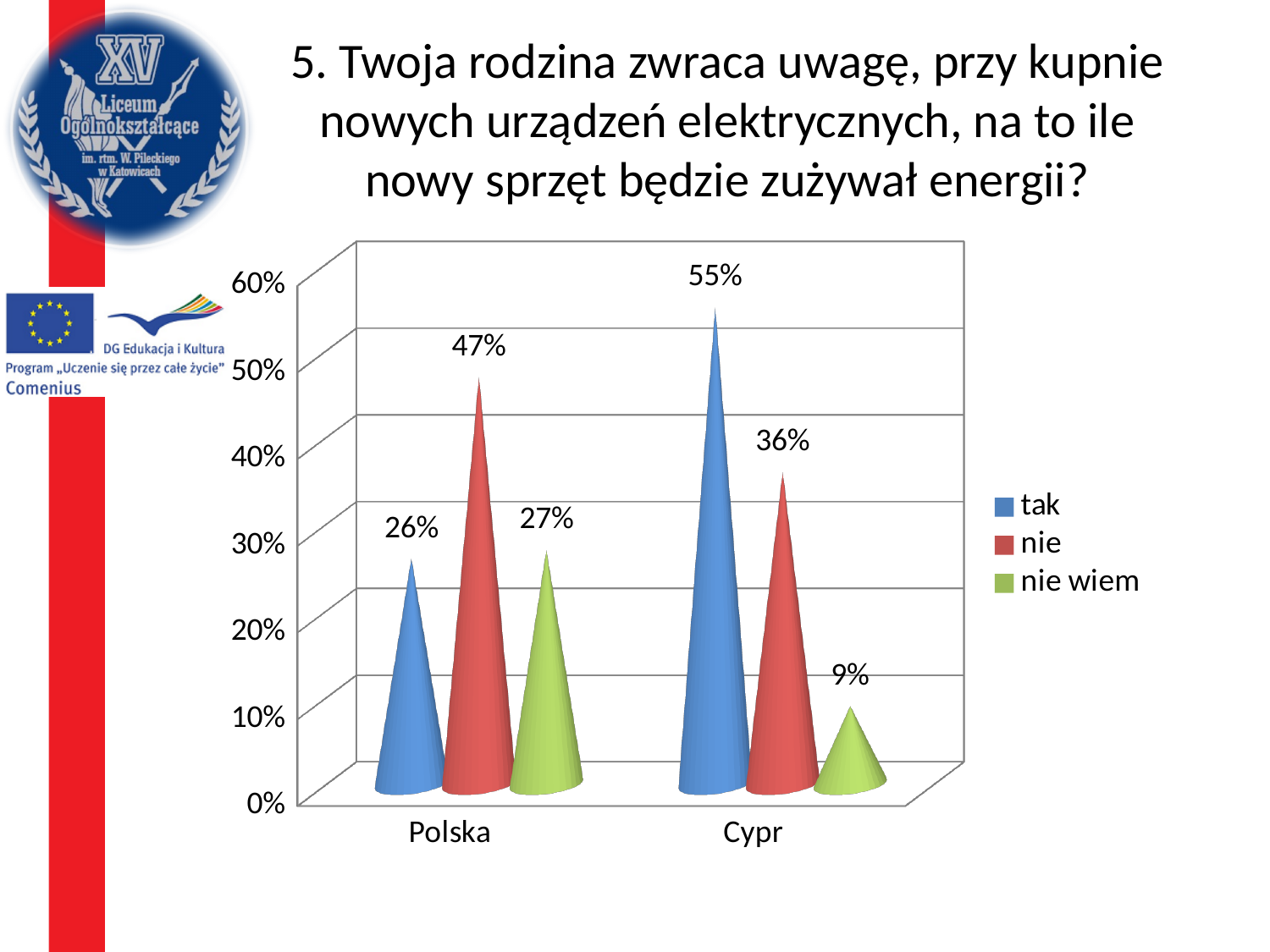
What kind of chart is shown on the slide? bar chart What is the value for "tak" for Polska? 26% What is the value for "nie wiem" for Cypr? 9% What is the difference between the "nie" values for Polska and Cypr? 11% Which is larger: "tak" for Polska or "tak" for Cypr? Cypr How many series does the legend list? 3 How many countries are shown on the x axis? 2 What colour represents the "nie wiem" series in the legend? green Which response has the lowest value for Polska? tak Is the value for "nie" for Polska greater or less than 40%? greater What is the value for "nie" for Cypr? 36% Which response has the highest value for Cypr? tak